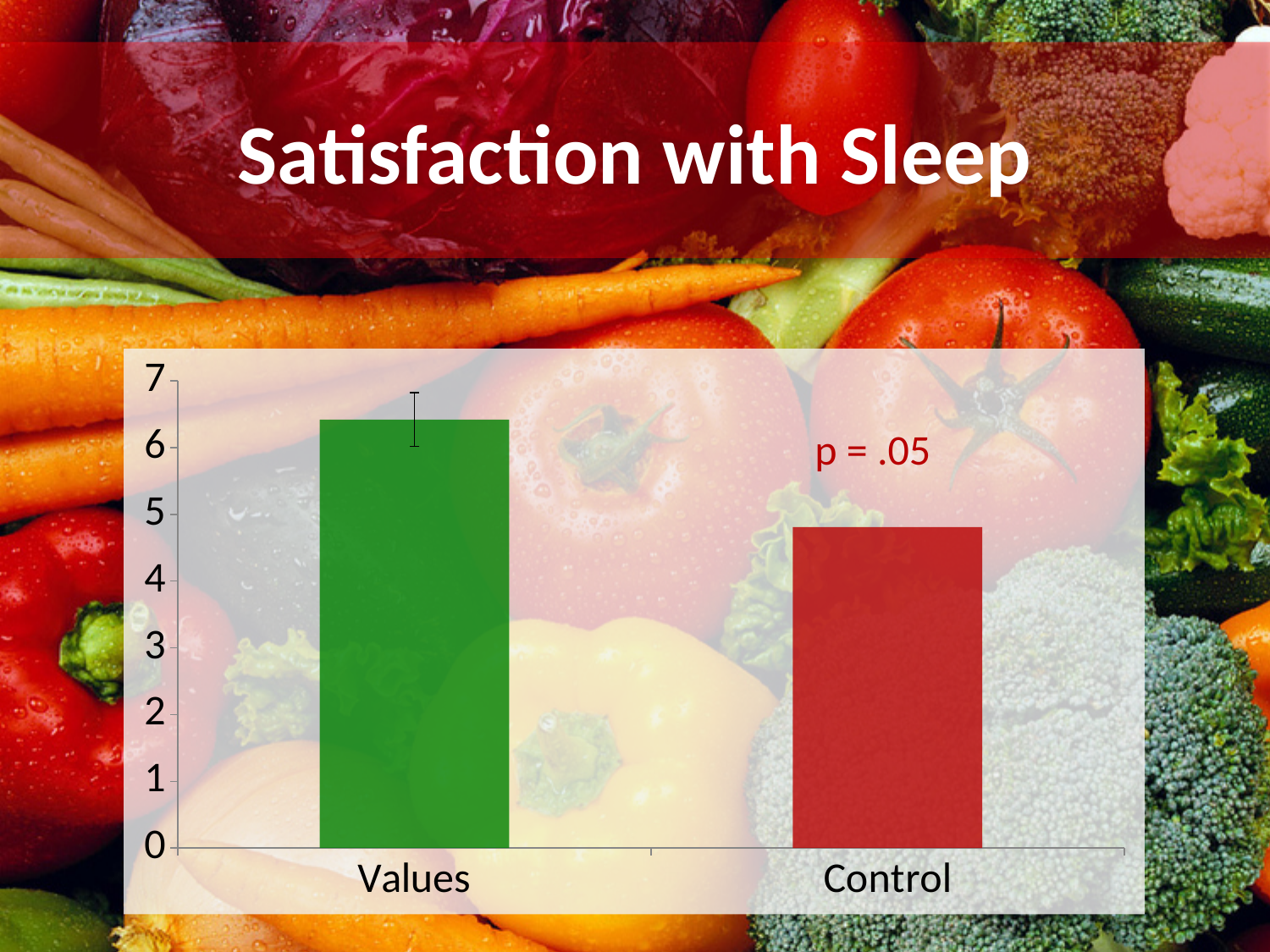
Is the value for Control greater or less than 5? less How many categories are plotted on the x axis? 2 Is the value for Values greater or less than 7? less Which category has the lowest bar? Control Which category has the highest bar? Values What kind of chart is shown on the slide? bar chart Is the value for Values greater or less than 6? greater What p-value is annotated on the chart? p = .05 What is the title of the slide above the chart? Satisfaction with Sleep Which is larger, the value for Values or the value for Control? Values